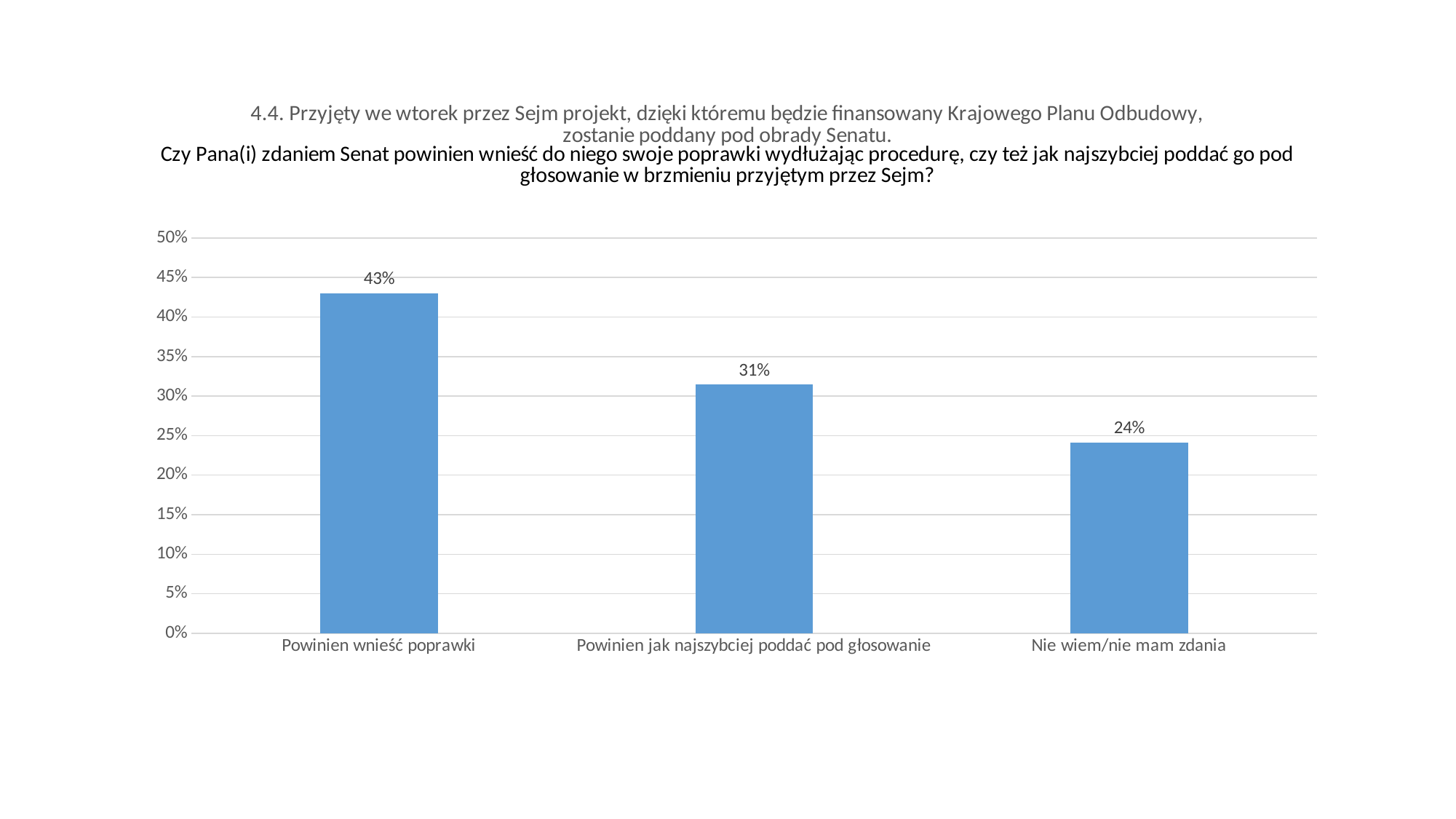
Which category has the lowest value? Nie wiem/nie mam zdania What is the value for "Powinien jak najszybciej poddać pod głosowanie"? 31% What is the value for "Nie wiem/nie mam zdania"? 24% What is the difference between "Powinien wnieść poprawki" and "Powinien jak najszybciej poddać pod głosowanie"? 12% What kind of chart is shown on the slide? bar chart Do the values rise or fall from left to right across the categories? fall What is the value for "Powinien wnieść poprawki"? 43% What is the difference between "Powinien jak najszybciej poddać pod głosowanie" and "Nie wiem/nie mam zdania"? 7% Is the value for "Powinien wnieść poprawki" greater or less than 40%? greater Which category has the highest value? Powinien wnieść poprawki How many categories are shown in the chart? 3 Which is larger: "Powinien jak najszybciej poddać pod głosowanie" or "Nie wiem/nie mam zdania"? Powinien jak najszybciej poddać pod głosowanie